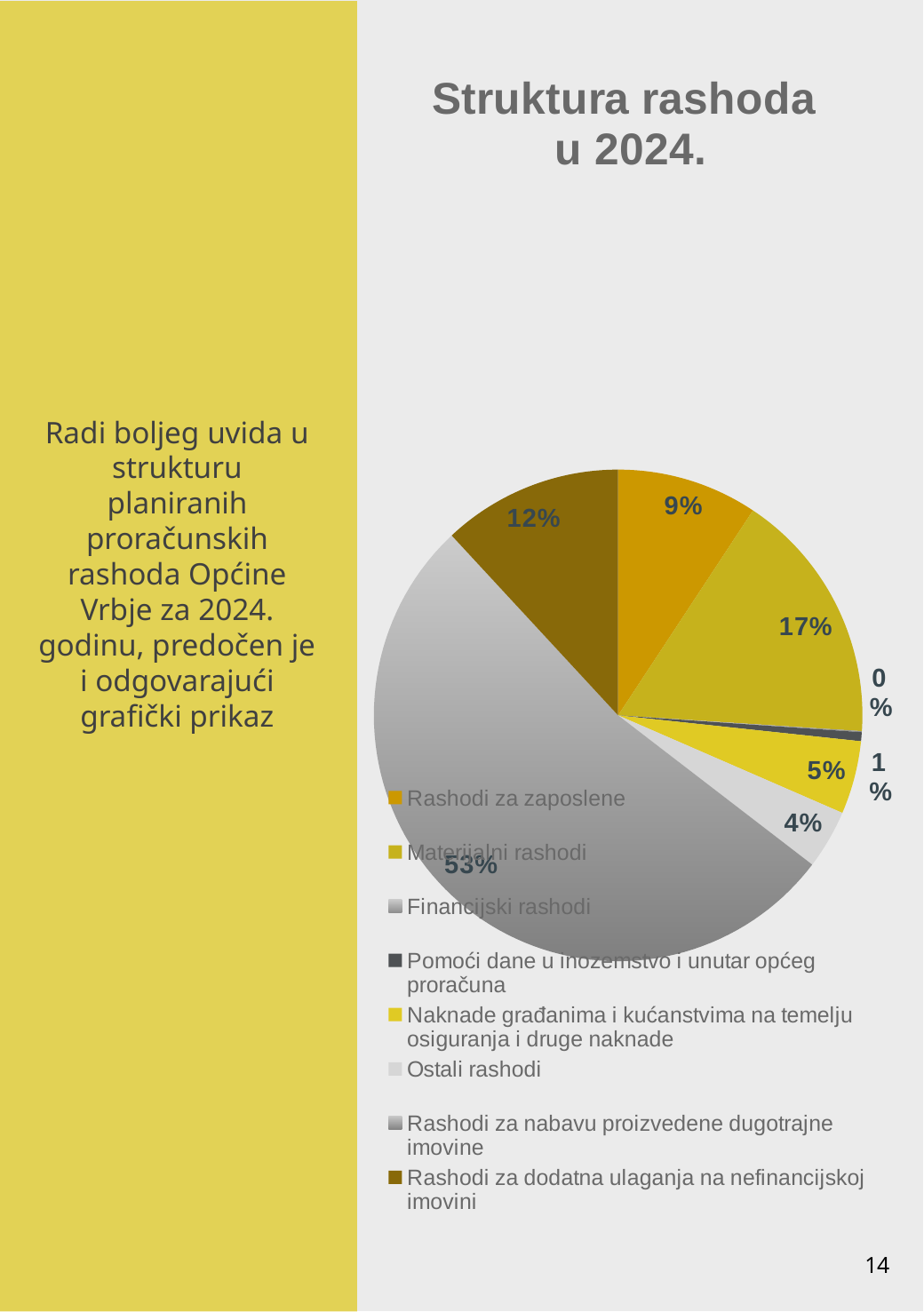
Which category has the largest slice of the pie? Rashodi za nabavu proizvedene dugotrajne imovine What share of the pie is Ostali rashodi? 4% What is the difference between the share for Rashodi za nabavu proizvedene dugotrajne imovine and the share for Materijalni rashodi? 36% What is the title of the chart? Struktura rashoda u 2024. What share of the pie is Rashodi za dodatna ulaganja na nefinancijskoj imovini? 12% Which category has the smallest slice of the pie? Financijski rashodi Which is larger, the slice for Materijalni rashodi or the slice for Rashodi za zaposlene? Materijalni rashodi How many entries does the chart legend list? 8 What share of the pie is Materijalni rashodi? 17% What kind of chart is shown on the slide? pie chart